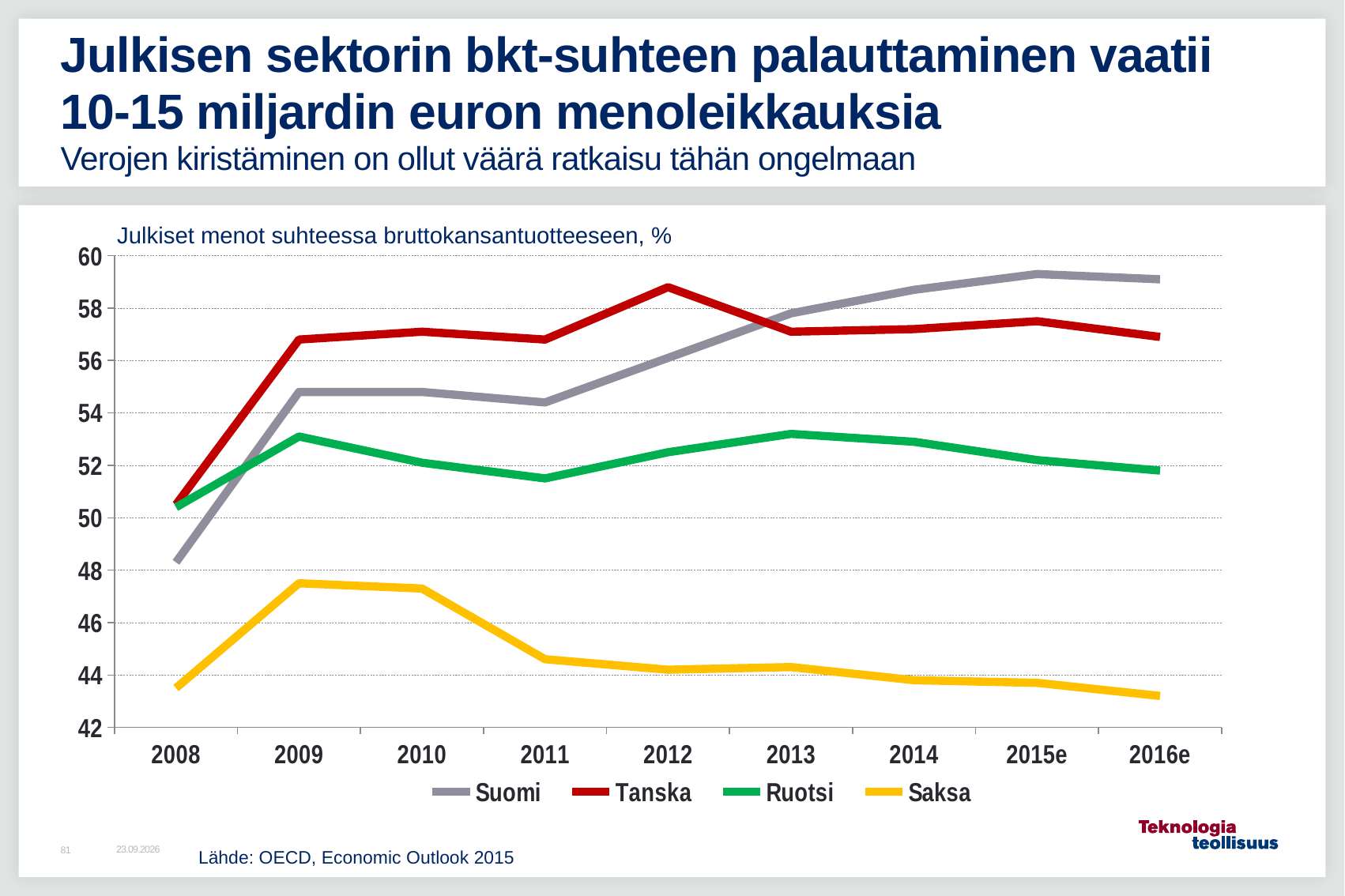
Which series has the highest value in 2012? Tanska In 2009, which is larger: the value for Tanska or the value for Suomi? Tanska Is the value for Suomi in 2008 greater or less than 50? less Which series has the lowest value in 2014? Saksa How many series does the legend list? 4 How many years are shown on the x axis? 9 Does the value for Saksa rise or fall from 2009 to 2016e? fall What is the title of the chart? Julkiset menot suhteessa bruttokansantuotteeseen, % Is the value for Tanska in 2012 greater or less than 58? greater Which series has the highest value in 2016e? Suomi What kind of chart is shown on the slide? line chart Is the value for Saksa in 2009 greater or less than 46? greater